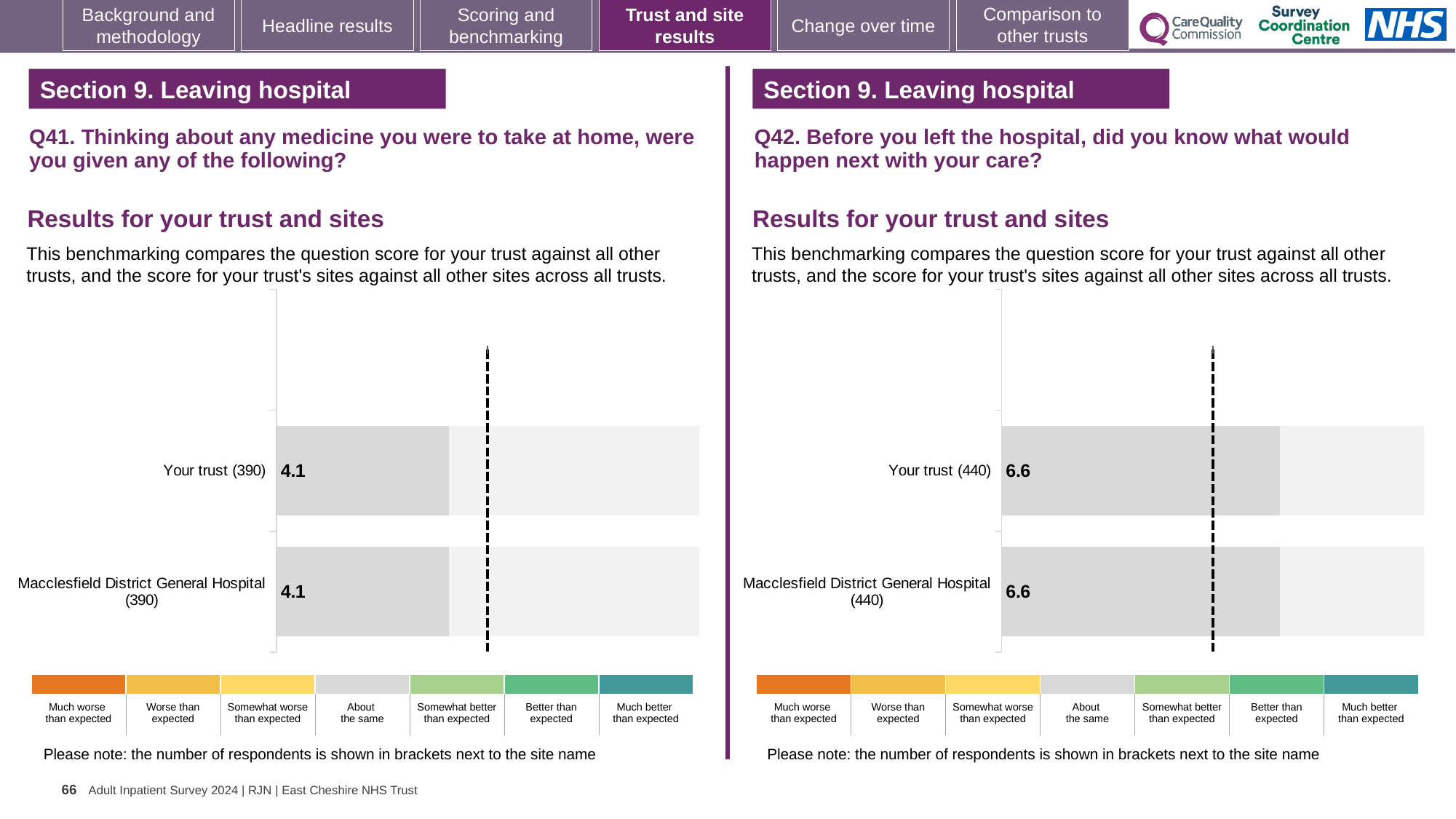
How many bars are plotted in the Q42 chart on the right? 2 How many bars are plotted in the Q41 chart on the left? 2 In the Q42 chart on the right, how many respondents are shown in brackets for Macclesfield District General Hospital? 440 How many categories does the colour key below the Q41 chart on the left list? 7 In the Q41 chart on the left, what is the score for Your trust? 4.1 What kind of chart is used for the Q42 results on the right? Bar chart In the Q41 chart on the left, what is the difference between the score for Your trust and the score for Macclesfield District General Hospital? 0 In the Q41 chart on the left, what is the score for Macclesfield District General Hospital? 4.1 In the Q42 chart on the right, what is the score for Your trust? 6.6 In the Q42 chart on the right, what is the score for Macclesfield District General Hospital? 6.6 In the Q42 chart on the right, what is the difference between the score for Your trust and the score for Macclesfield District General Hospital? 0 In the Q41 chart on the left, how many respondents are shown in brackets for Your trust? 390